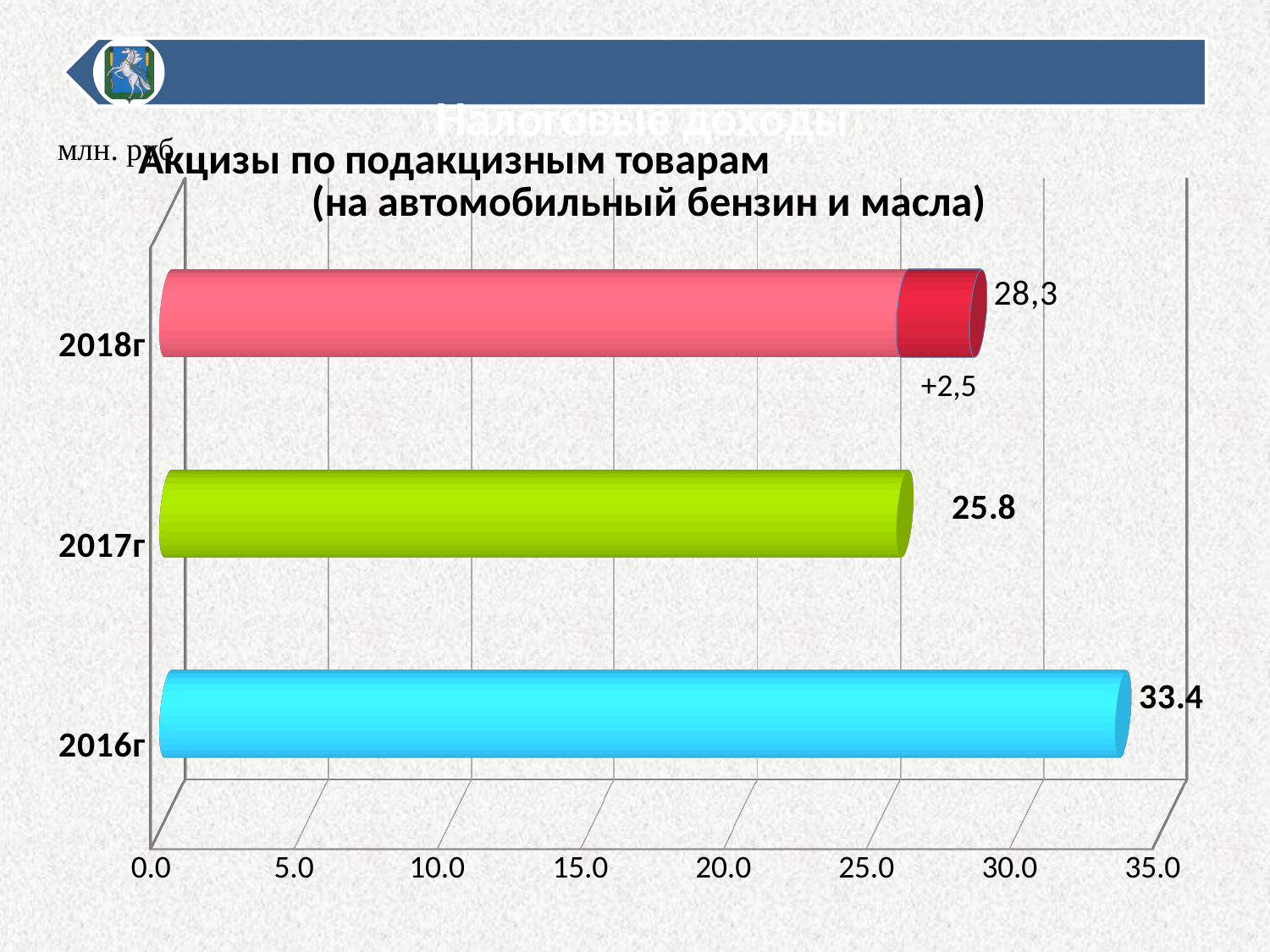
Which is larger, the value for 2018г or the value for 2016г? 2016г By how much did the value increase from 2017г to 2018г, as labelled on the chart? +2,5 What is the value for 2016г? 33.4 By how much does the value for 2016г exceed the value for 2017г? 7.6 What type of chart is shown on the slide? bar chart In what units are the values on the chart expressed? млн. руб How many years are shown on the chart? 3 Which year has the lowest value? 2017г Which year has the highest value? 2016г What is the value for 2018г? 28,3 What is the value for 2017г? 25.8 Is the value for 2017г greater or less than 30.0? less